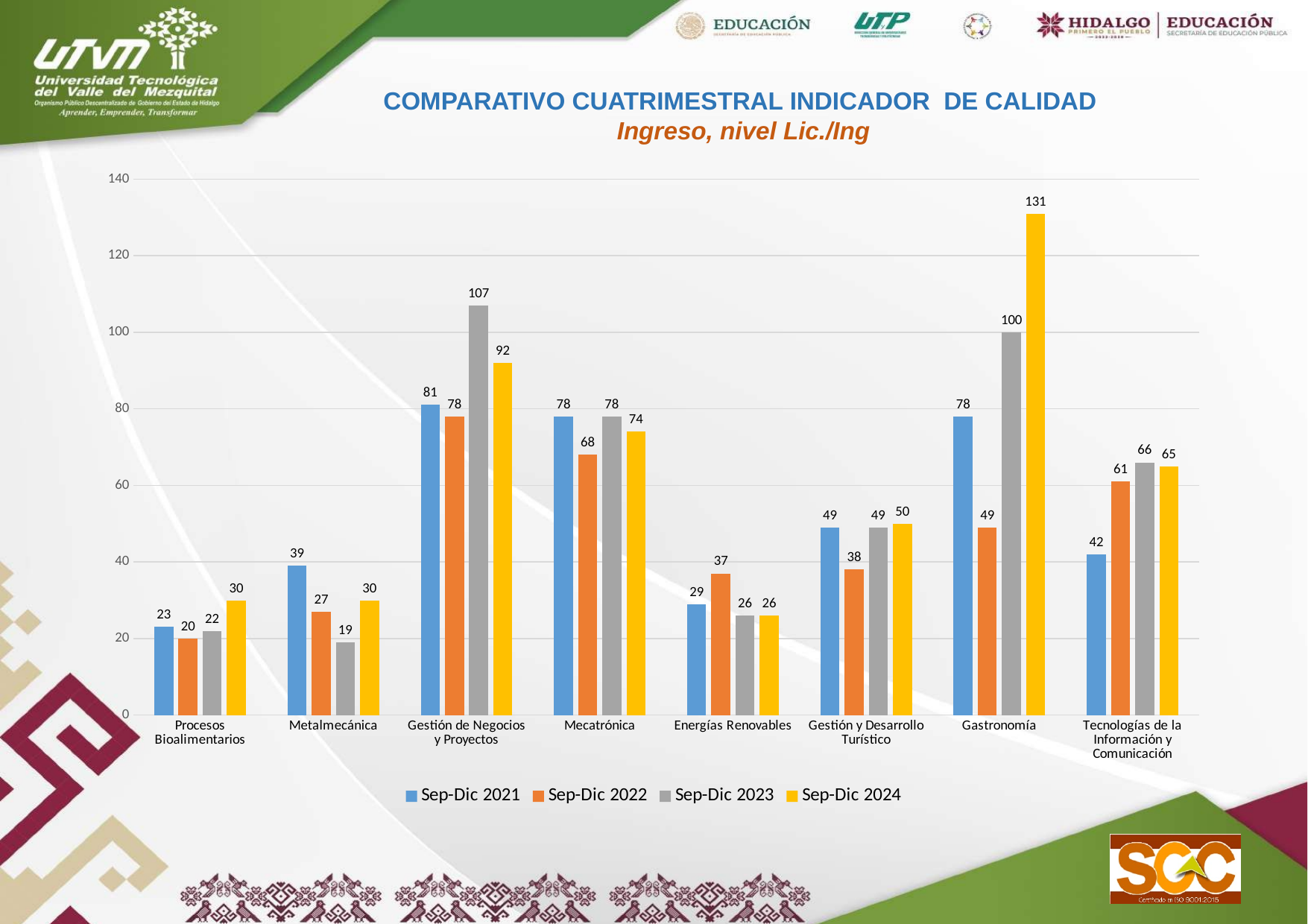
What is the Sep-Dic 2024 value for Gastronomía? 131 How many categories (programs) are shown on the x axis? 8 What is the Sep-Dic 2022 value for Energías Renovables? 37 What is the difference between the Sep-Dic 2024 and Sep-Dic 2021 values for Gastronomía? 53 Which category has the lowest Sep-Dic 2023 value? Metalmecánica What type of chart is shown on the slide? bar chart How many series does the legend list? 4 Which category has the highest Sep-Dic 2024 value? Gastronomía Do the values for Tecnologías de la Información y Comunicación rise or fall from Sep-Dic 2021 to Sep-Dic 2023? rise Which is larger for Metalmecánica: the Sep-Dic 2021 value or the Sep-Dic 2024 value? Sep-Dic 2021 What is the Sep-Dic 2023 value for Gestión de Negocios y Proyectos? 107 What colour represents the Sep-Dic 2024 series in the legend? yellow